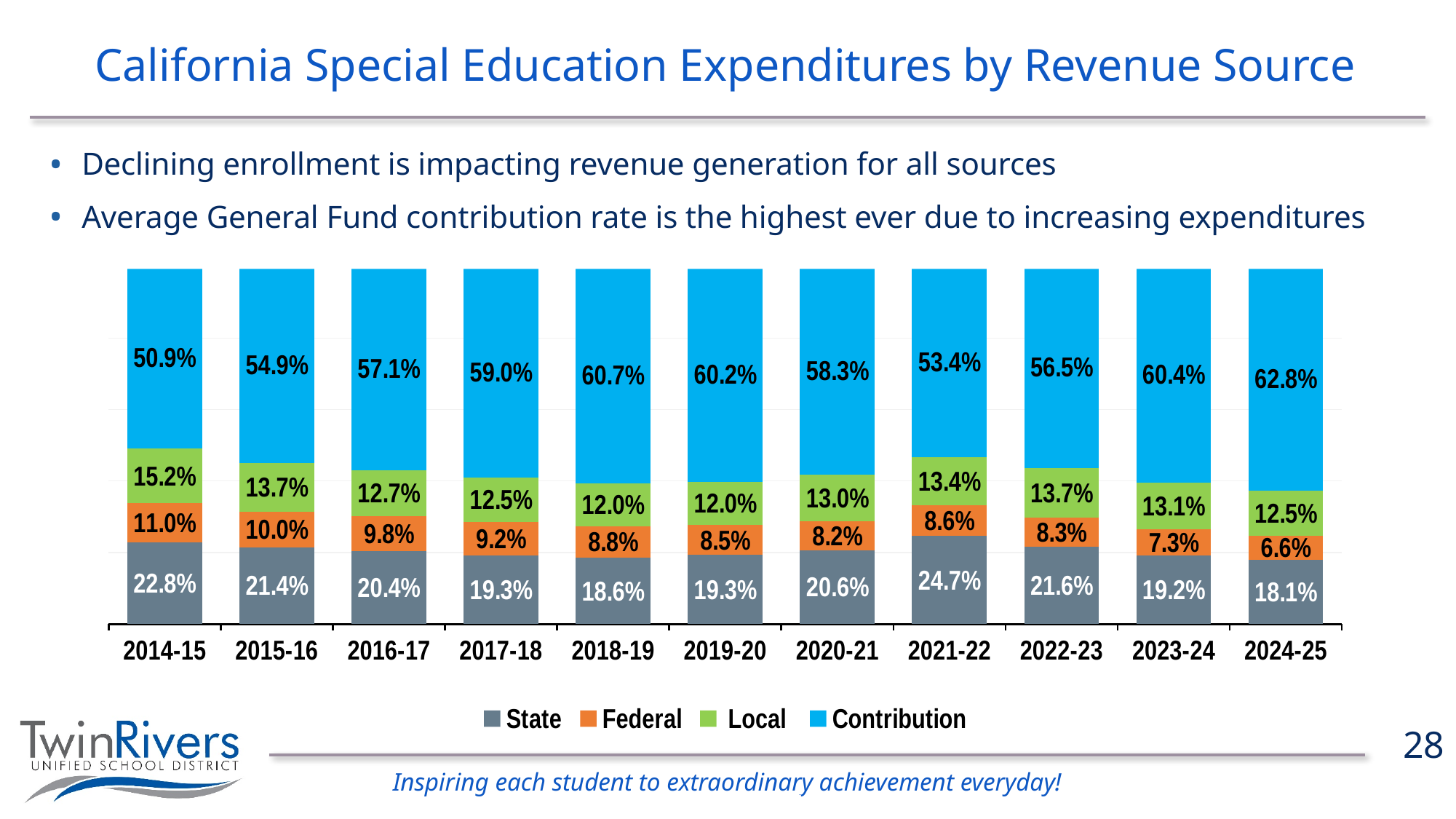
Which year has the larger State share, 2021-22 or 2022-23? 2021-22 In which year is the Contribution share the lowest? 2014-15 What is the Contribution share for 2024-25? 62.8% What kind of chart is shown on the slide? Stacked bar chart How many series does the legend list? 4 In which year is the Federal share the lowest? 2024-25 What is the Federal share for 2014-15? 11.0% What is the State share for 2021-22? 24.7% How many fiscal years are shown on the x axis? 11 In which year is the Contribution share the highest? 2024-25 What is the Local share for 2020-21? 13.0% By how many percentage points does the Contribution share in 2024-25 exceed that in 2014-15? 11.9 percentage points